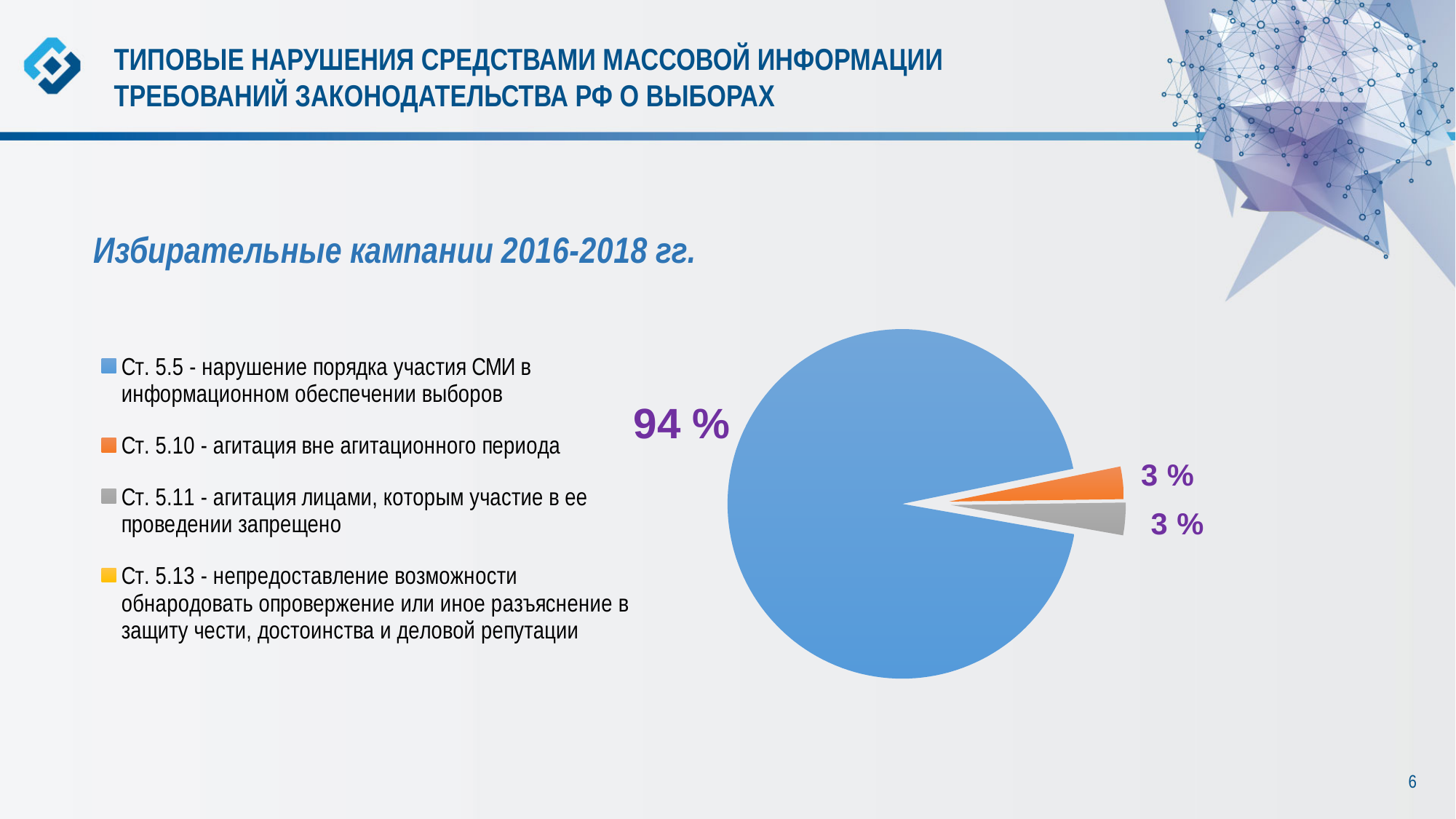
What share of the pie is labelled for Ст. 5.11 (агитация лицами, которым участие в ее проведении запрещено)? 3 % Which category has the largest slice of the pie? Ст. 5.5 - нарушение порядка участия СМИ в информационном обеспечении выборов How many entries does the legend of the pie chart list? 4 What share of the pie is labelled for Ст. 5.10 (агитация вне агитационного периода)? 3 % What kind of chart is shown on the slide? Pie chart What share of the pie is labelled for Ст. 5.5 (нарушение порядка участия СМИ в информационном обеспечении выборов)? 94 % What period does the heading above the pie chart refer to? Избирательные кампании 2016-2018 гг. Is the share for Ст. 5.5 greater or less than 50%? greater What is the difference in percentage points between the slice for Ст. 5.5 and the slice for Ст. 5.10? 91 % What colour is the slice for Ст. 5.10 (агитация вне агитационного периода)? Orange Which slice is larger: Ст. 5.5 or Ст. 5.11? Ст. 5.5